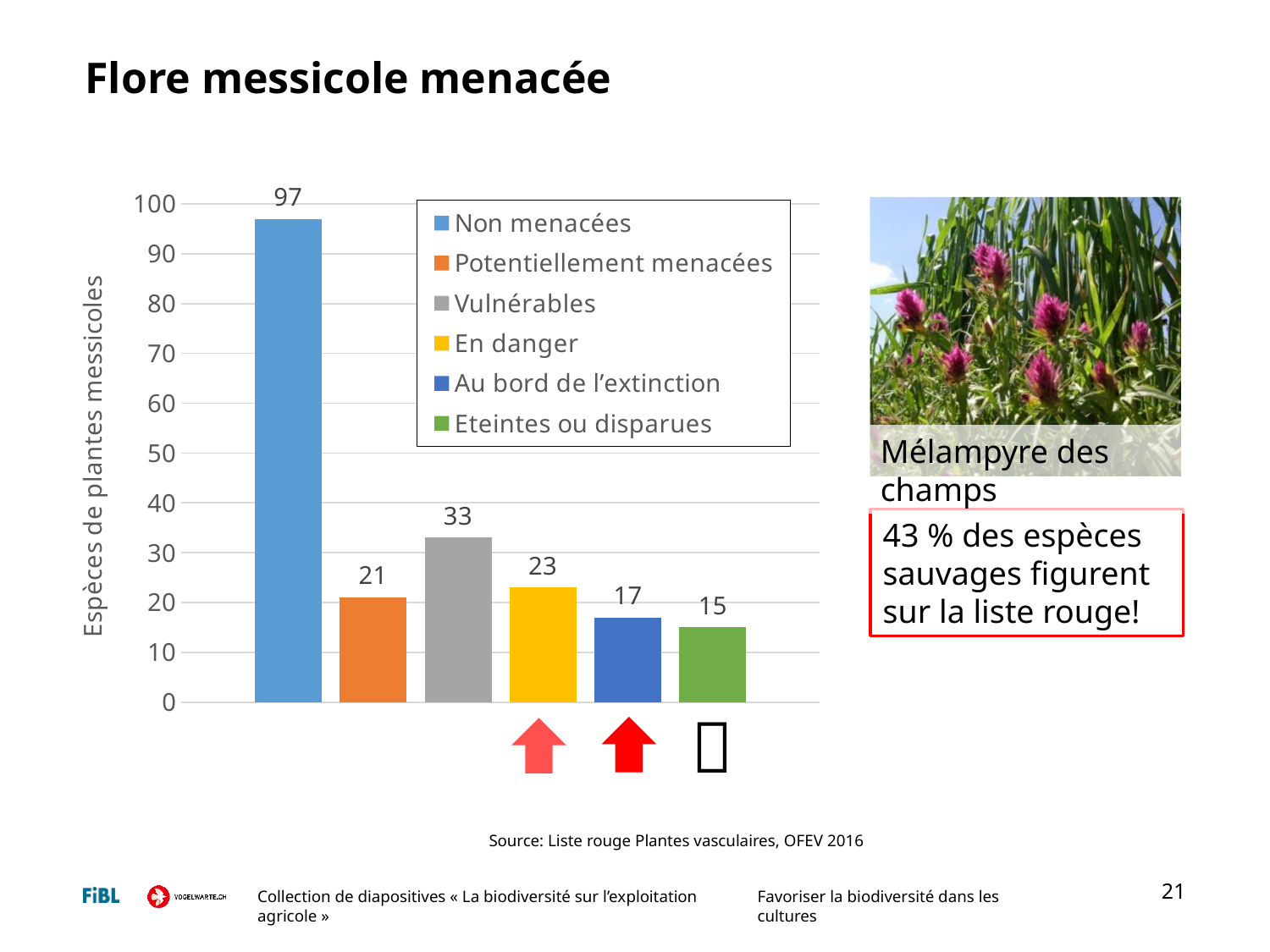
What is the value for Non menacées? 97 What is the value for Eteintes ou disparues? 15 What is the difference between the values for Non menacées and Vulnérables? 64 Which category has the lowest value? Eteintes ou disparues What is the value for Au bord de l'extinction? 17 How many series does the legend list? 6 What kind of chart is shown on the slide? Bar chart Which category has the highest value? Non menacées Which is larger, the value for Vulnérables or the value for En danger? Vulnérables What is the value for Vulnérables? 33 What is the difference between the values for En danger and Potentiellement menacées? 2 What is the label of the vertical axis? Espèces de plantes messicoles